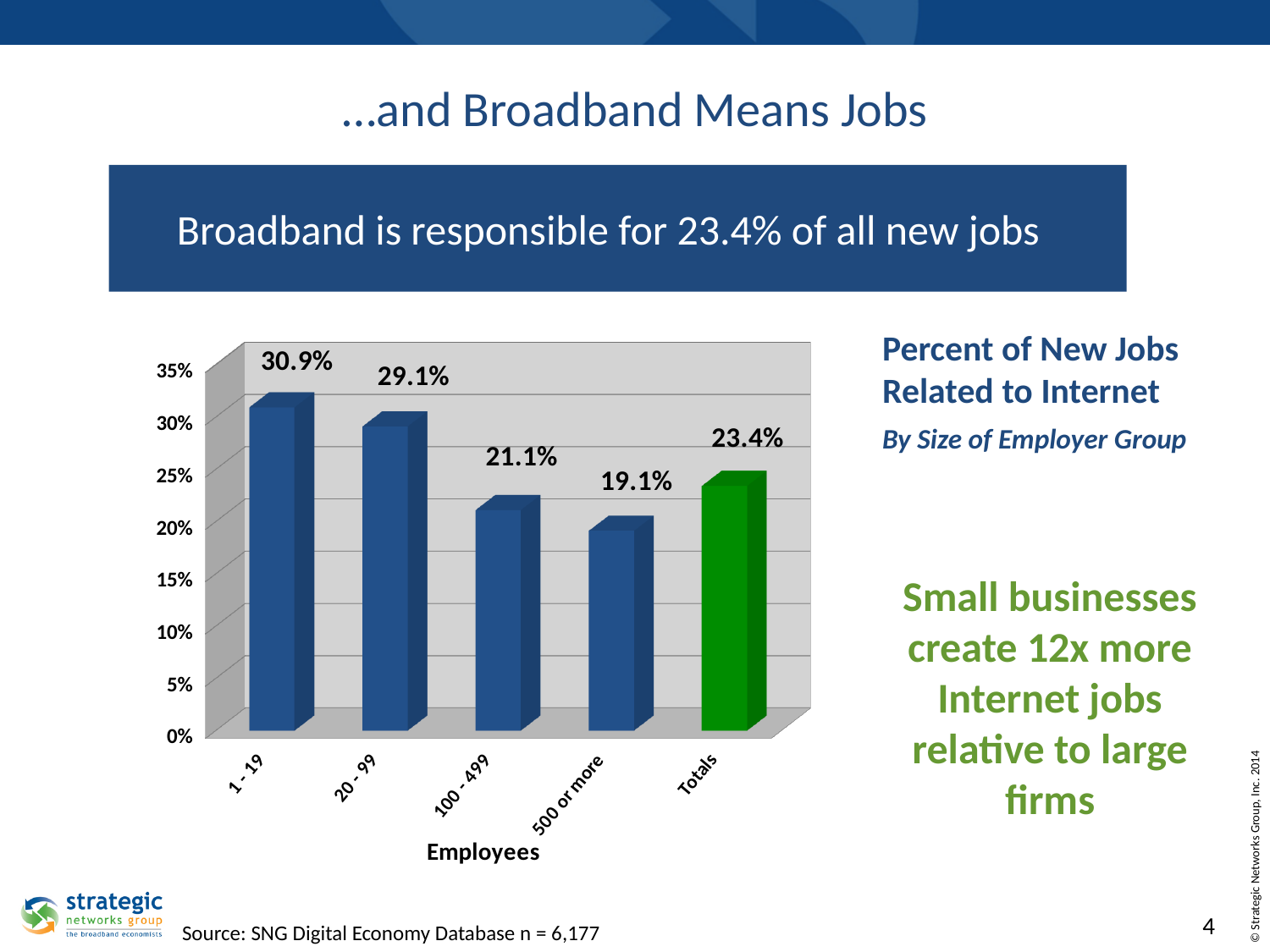
Which category has the highest value? 1 - 19 Do the values rise or fall from 1 - 19 to 500 or more? fall What kind of chart is shown on the slide? bar chart What is the value for the 500 or more employees category? 19.1% What is the value for the 1 - 19 employees category? 30.9% What is the x axis title of the chart? Employees How many categories are shown on the x axis? 5 Is the value for 100 - 499 greater or less than 25%? less What is the value for the Totals bar? 23.4% Which category has the lowest value? 500 or more What is the difference between the values for 1 - 19 and 500 or more? 11.8% Which is larger, the value for 20 - 99 or the value for 100 - 499? 20 - 99